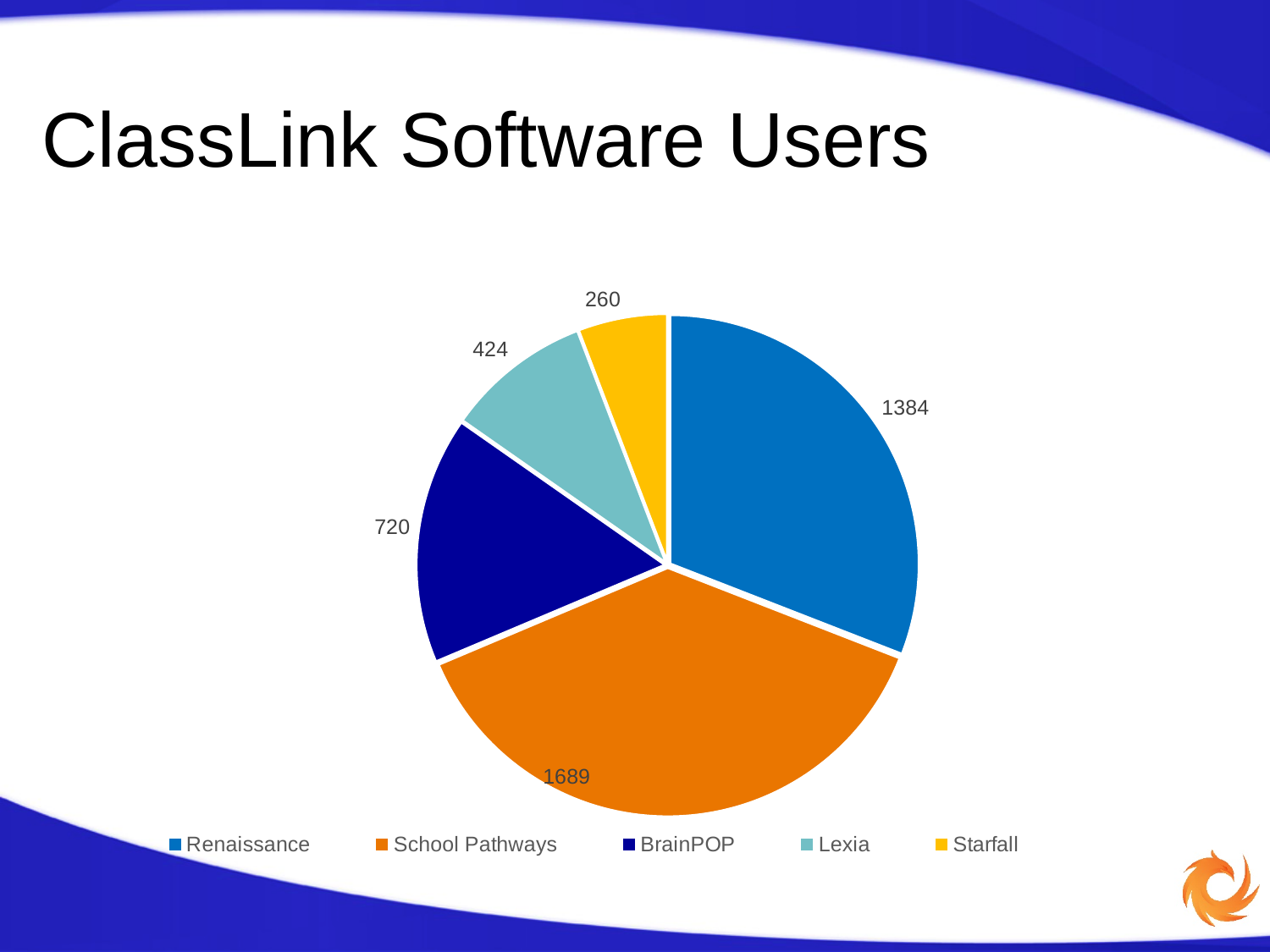
What is the value for BrainPOP? 720 Which software has the highest number of users? School Pathways What is the difference between the values for School Pathways and Renaissance? 305 Which software has the lowest number of users? Starfall What is the value for Renaissance? 1384 What is the value for Lexia? 424 What is the title of the slide? ClassLink Software Users What is the value for Starfall? 260 What kind of chart is shown on the slide? pie chart Which is larger, the value for BrainPOP or the value for Lexia? BrainPOP How many slices does the pie chart have? 5 What is the value for School Pathways? 1689